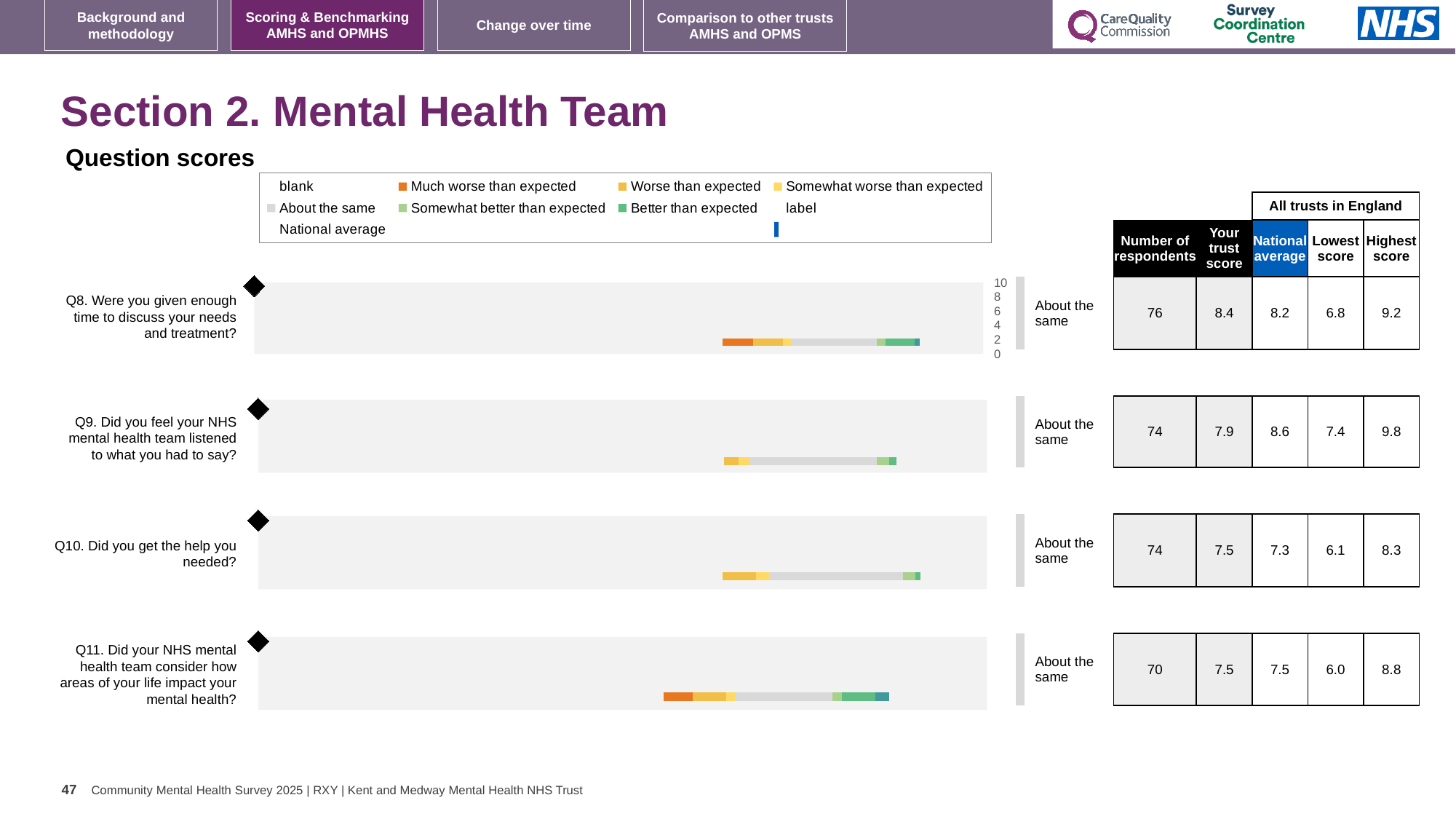
For Q8, what is the 'Your trust score' value shown? 8.4 For Q8, what is the difference between the highest score and the lowest score among all trusts in England? 2.4 What kind of chart is used for the question scores on this slide? Bar chart For Q9, what is the national average score shown? 8.6 What colour does the legend use for 'Much worse than expected'? Orange How many questions (Q8 to Q11) have a bar chart on this slide? 4 For Q11, what is the lowest score among all trusts in England? 6.0 For Q9, which is larger: the trust score or the national average? National average For Q10, how many respondents are shown? 74 Which question has the lowest number of respondents on this slide? Q11 What is the highest tick value on the axis shown beside the Q8 chart? 10 Which question has the highest 'Your trust score' on this slide? Q8